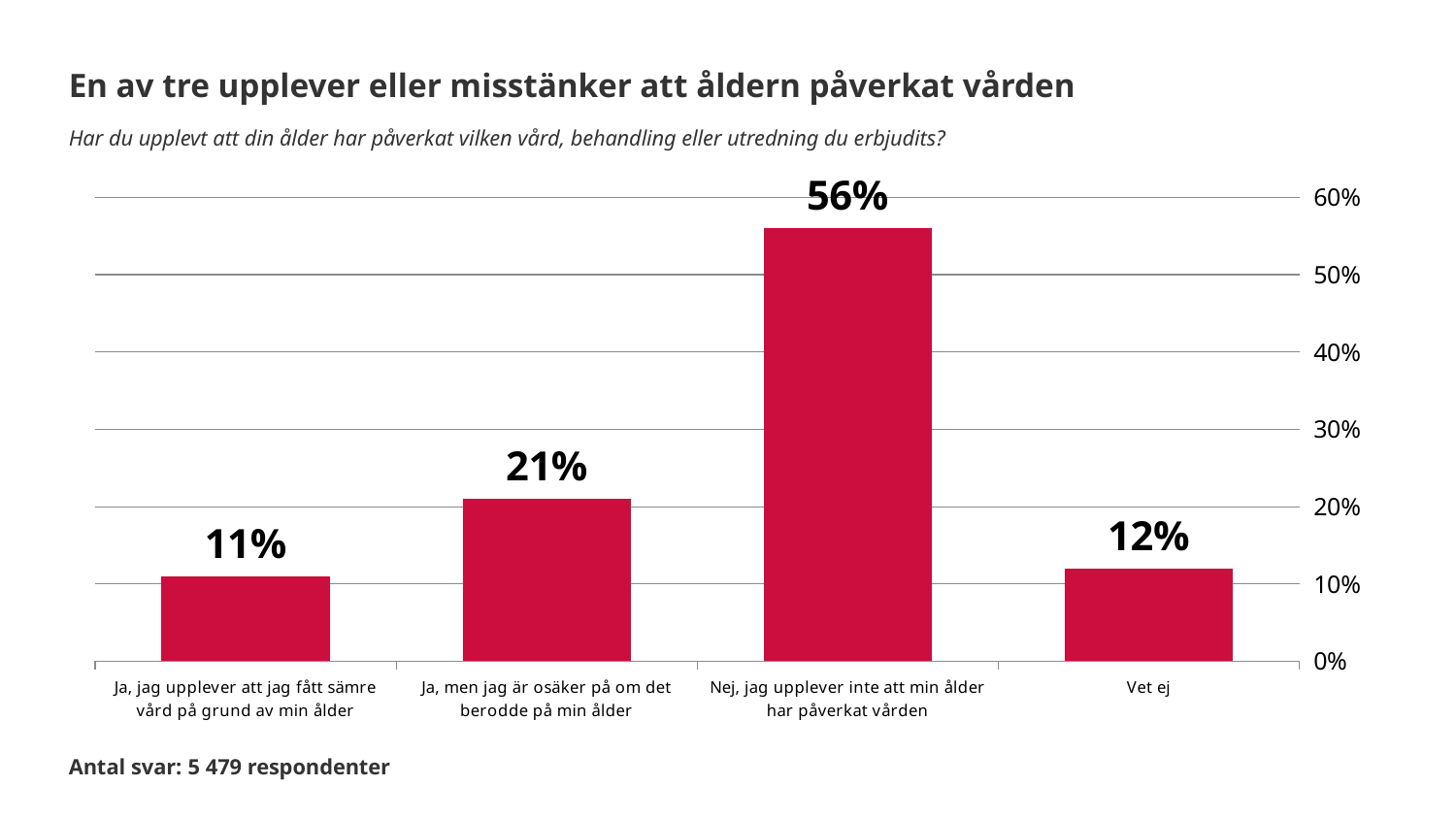
How many respondents answered the survey, according to the note below the chart? 5 479 respondenter Which answer option has the lowest value? Ja, jag upplever att jag fått sämre vård på grund av min ålder What is the value for "Ja, men jag är osäker på om det berodde på min ålder"? 21% What is the value for "Nej, jag upplever inte att min ålder har påverkat vården"? 56% What type of chart is shown on the slide? Bar chart What is the value for "Ja, jag upplever att jag fått sämre vård på grund av min ålder"? 11% Which is larger: the value for "Vet ej" or the value for "Ja, jag upplever att jag fått sämre vård på grund av min ålder"? Vet ej What is the difference in percentage points between "Nej, jag upplever inte att min ålder har påverkat vården" and "Ja, men jag är osäker på om det berodde på min ålder"? 35 percentage points How many answer categories are shown in the chart? 4 Which answer option has the highest value? Nej, jag upplever inte att min ålder har påverkat vården What percentage of respondents answered "Vet ej"? 12% Is the value for "Ja, men jag är osäker på om det berodde på min ålder" greater or less than 30%? less